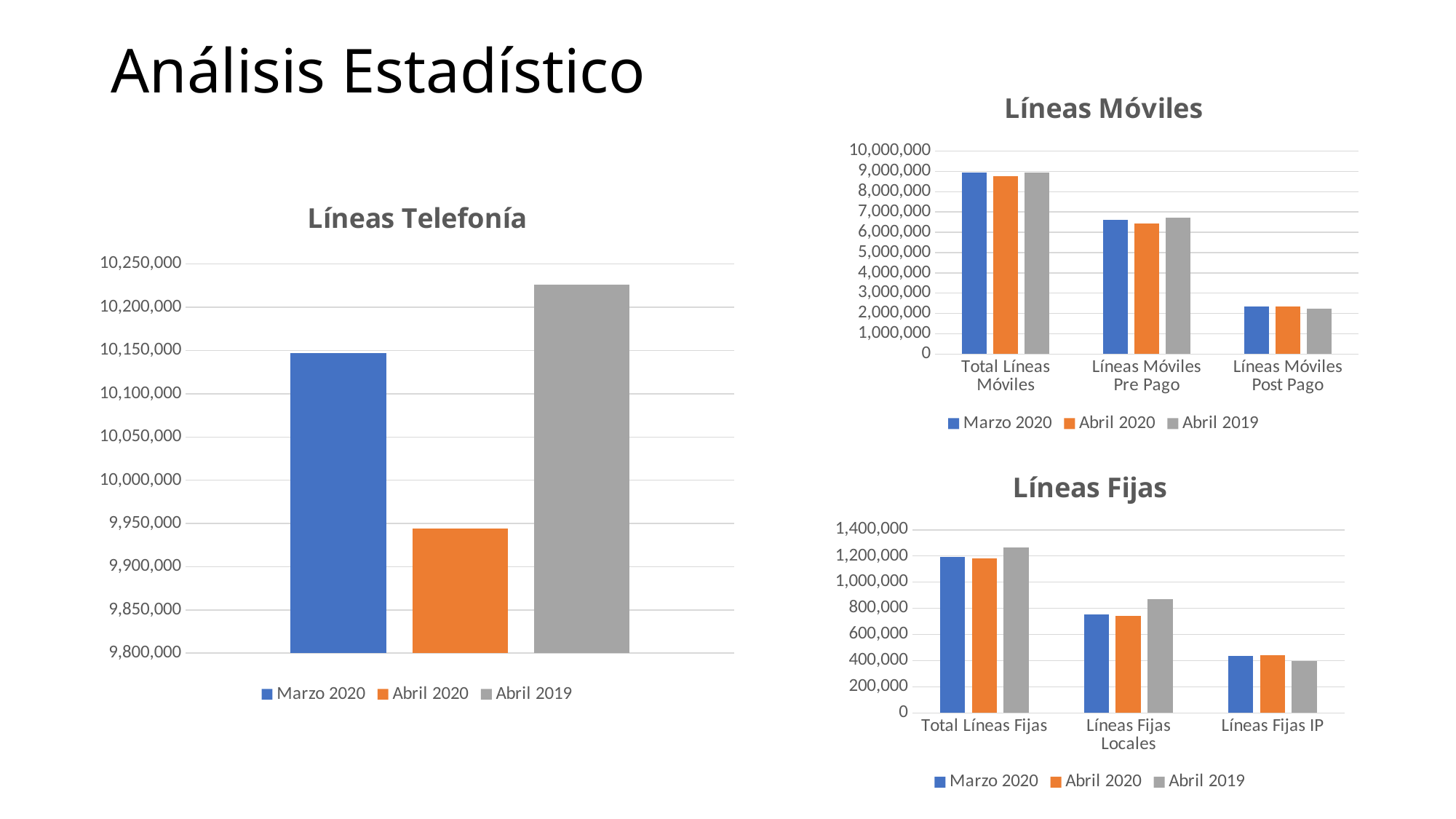
How many series does the legend of the Líneas Telefonía chart list? 3 In the Líneas Fijas chart, for Líneas Fijas Locales, which is larger: Abril 2020 or Abril 2019? Abril 2019 In the Líneas Fijas chart, is the Abril 2019 value for Líneas Fijas Locales greater or less than 800,000? greater In the Líneas Telefonía chart, which series has the lowest value? Abril 2020 In the Líneas Móviles chart, is the Abril 2020 value for Líneas Móviles Pre Pago greater or less than 6,000,000? greater What kind of chart is the Líneas Móviles chart? bar chart In the Líneas Fijas chart, which series has the highest value for Total Líneas Fijas? Abril 2019 In the Líneas Telefonía chart, is the value for Abril 2020 greater or less than 10,000,000? less In the Líneas Telefonía chart, which series has the highest value? Abril 2019 How many categories are shown on the x axis of the Líneas Móviles chart? 3